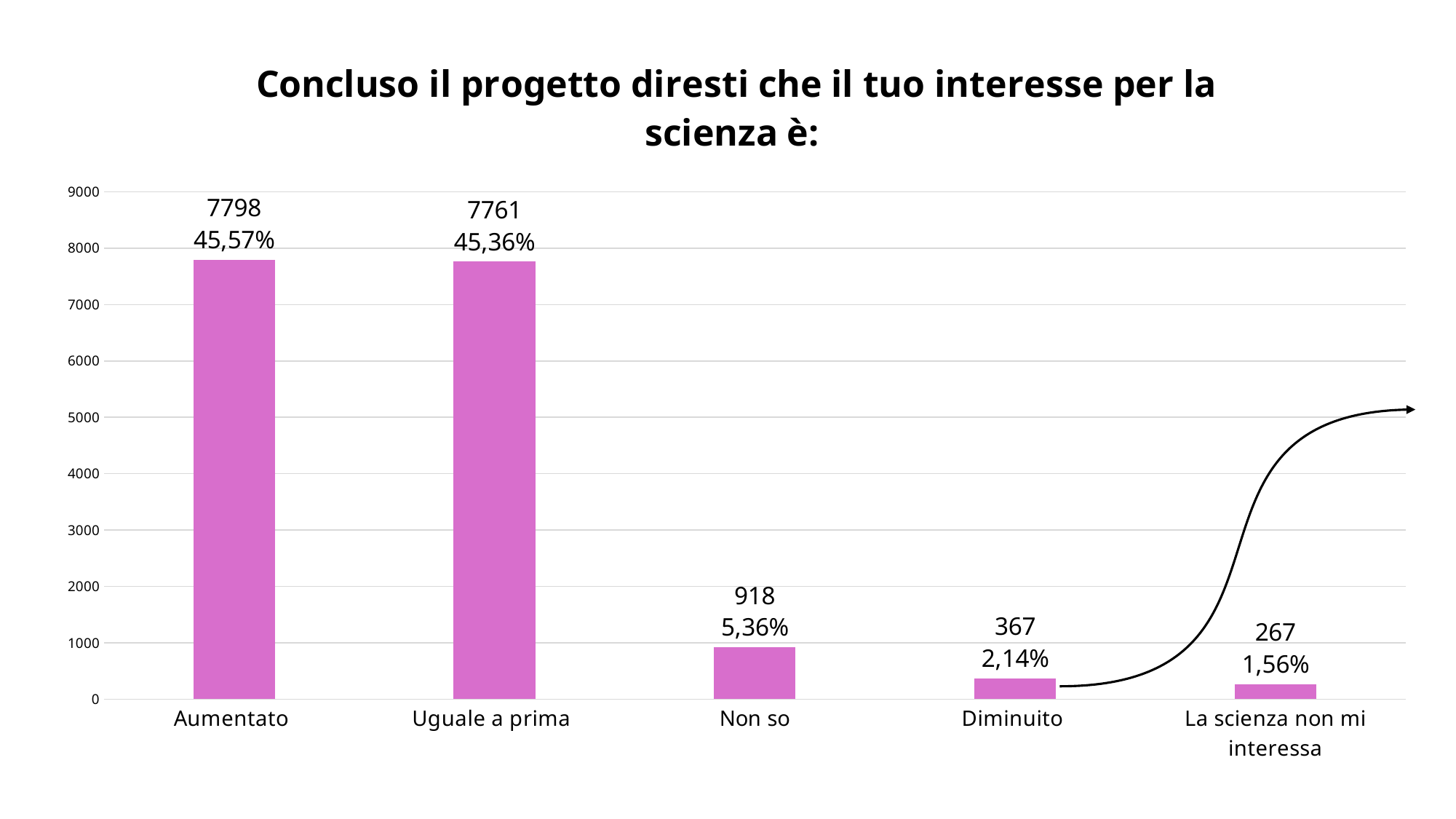
What is the difference between the values for "Aumentato" and "Uguale a prima"? 37 Which category has the highest value? Aumentato How many categories are shown on the x axis? 5 What percentage is shown for "Diminuito"? 2,14% What percentage is shown for "Uguale a prima"? 45,36% Which category has the lowest value? La scienza non mi interessa What kind of chart is this? Bar chart Which is larger, the value for "Non so" or the value for "Diminuito"? Non so What is the value for "Aumentato"? 7798 What is the title of the chart? Concluso il progetto diresti che il tuo interesse per la scienza è: What is the value for "La scienza non mi interessa"? 267 What is the value for "Non so"? 918